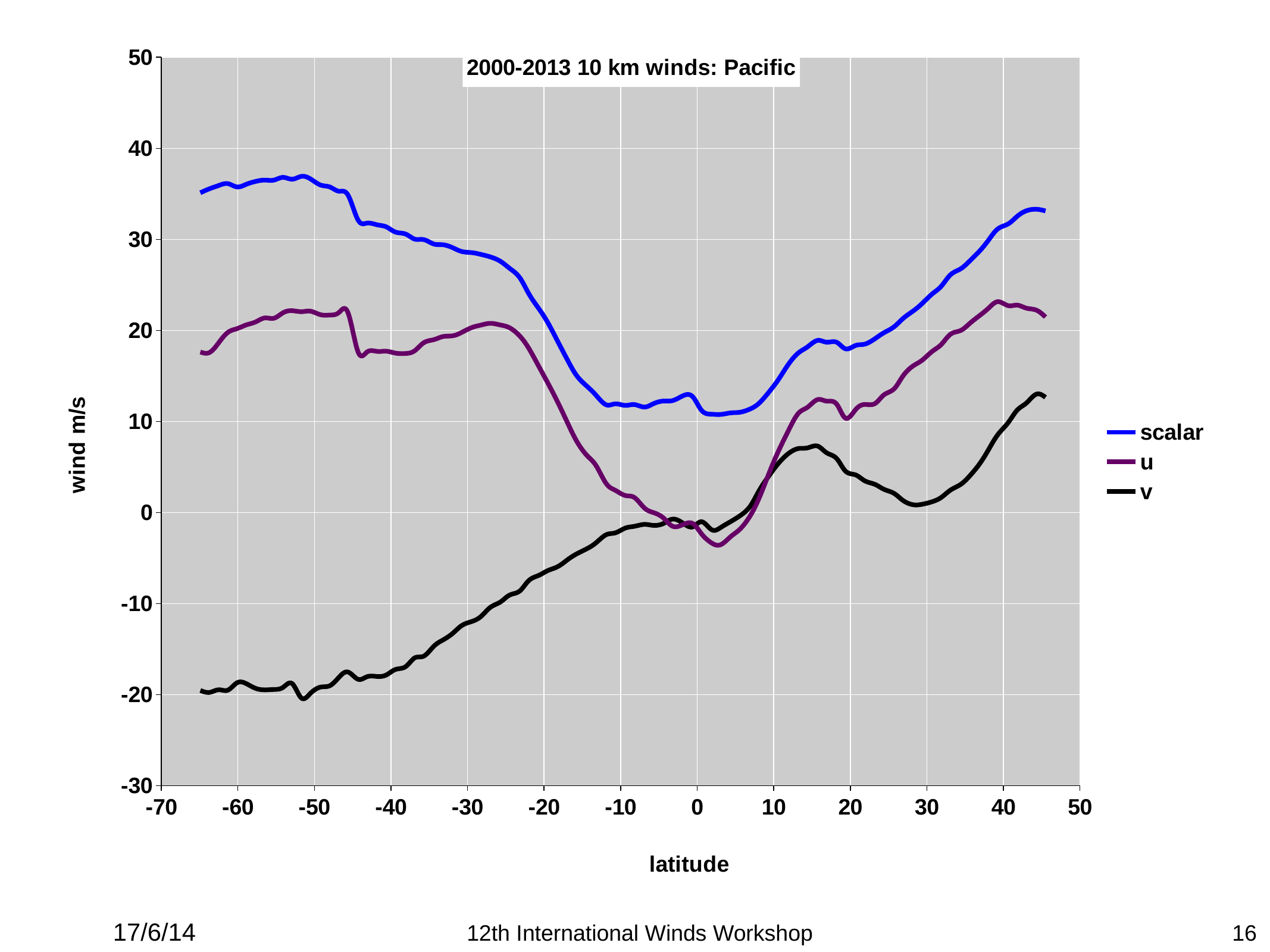
Which series has the lowest value at latitude -40? v Does the v series rise or fall as latitude increases from -60 to 0? rise What is the label on the y axis of the chart? wind m/s How many series does the legend list? 3 Is the value of the u series at latitude 0 greater or less than 10? less At latitude -50, which series has the larger value, u or v? u Is the value of the u series at latitude 40 greater or less than 20? greater Is the value of the scalar series at latitude 20 greater or less than 10? greater What is the title of the chart? 2000-2013 10 km winds: Pacific What kind of chart is shown on the slide? line chart